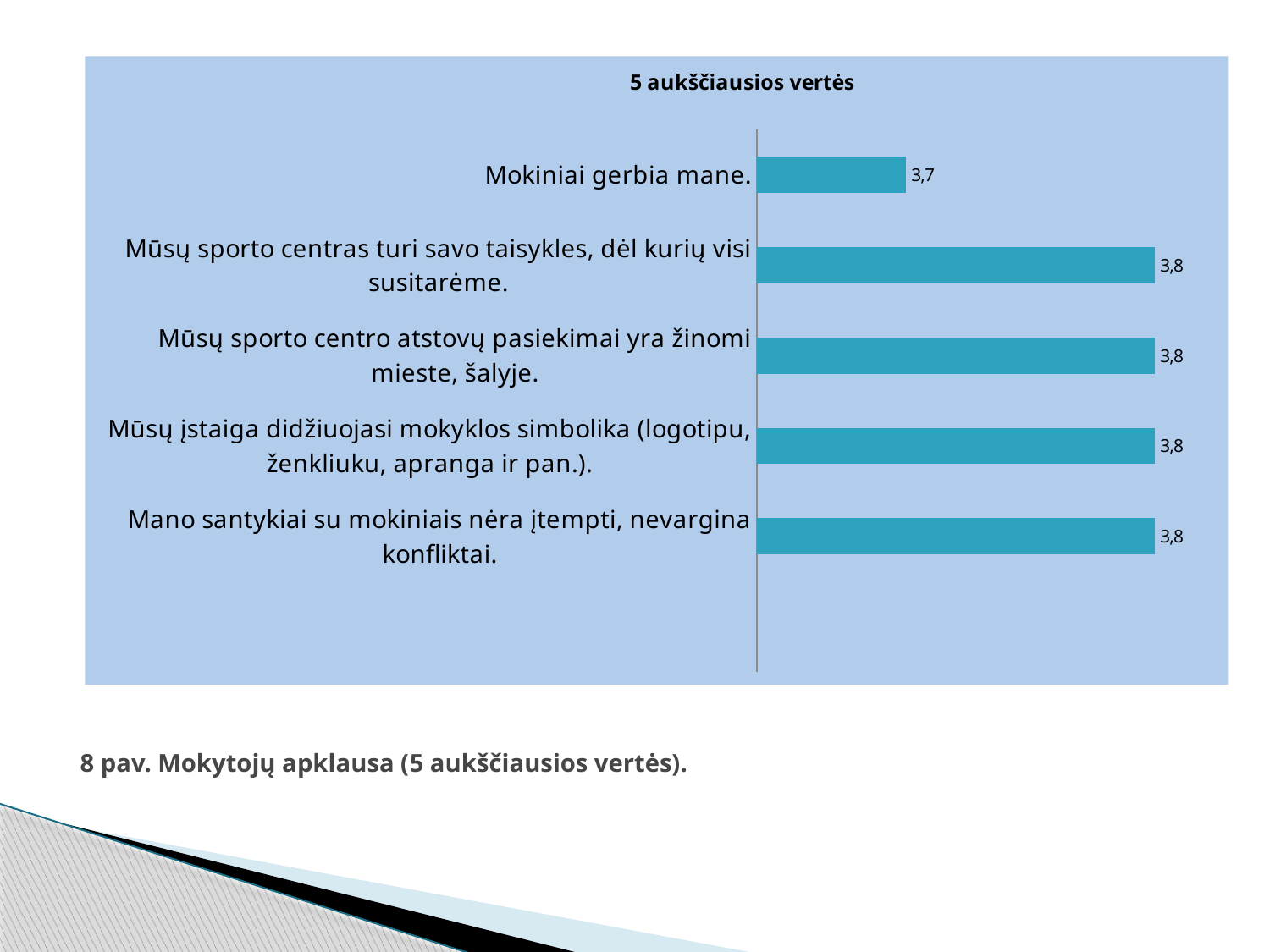
What is the title of the chart? 5 aukščiausios vertės What is the difference between the value for "Mūsų sporto centro atstovų pasiekimai yra žinomi mieste, šalyje." and the value for "Mokiniai gerbia mane."? 0,1 Which is larger: the value for "Mokiniai gerbia mane." or the value for "Mano santykiai su mokiniais nėra įtempti, nevargina konfliktai."? Mano santykiai su mokiniais nėra įtempti, nevargina konfliktai. What is the value for "Mano santykiai su mokiniais nėra įtempti, nevargina konfliktai."? 3,8 What is the value for "Mūsų sporto centras turi savo taisykles, dėl kurių visi susitarėme."? 3,8 How many categories are shown in the chart? 5 How many categories have a value of 3,8? 4 What is the value for "Mūsų įstaiga didžiuojasi mokyklos simbolika (logotipu, ženkliuku, apranga ir pan.)."? 3,8 What is the value for "Mokiniai gerbia mane."? 3,7 What is the caption below the chart? 8 pav. Mokytojų apklausa (5 aukščiausios vertės). What kind of chart is shown on the slide? Bar chart Which category has the lowest value? Mokiniai gerbia mane.